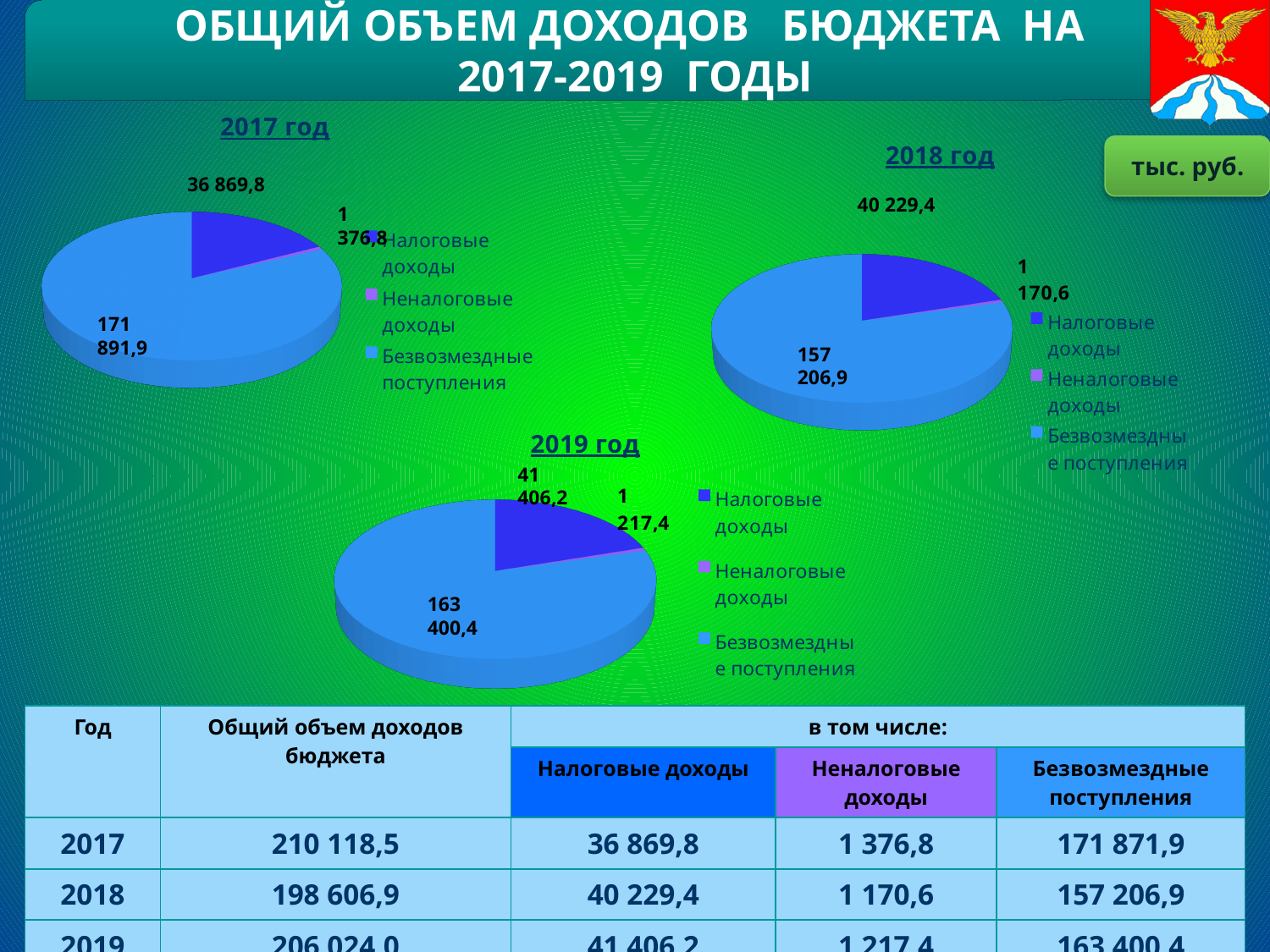
In the 2018 год pie chart, which category has the largest slice? Безвозмездные поступления In the 2018 год pie chart, what is the value for Безвозмездные поступления? 157 206,9 What kind of chart is used for the 2019 год data? Pie chart How many categories does the legend of the 2018 год chart list? 3 How many pie charts are shown on the slide? 3 In the 2018 год pie chart, which is larger: Налоговые доходы or Неналоговые доходы? Налоговые доходы In the 2019 год pie chart, what is the value for Безвозмездные поступления? 163 400,4 In the 2019 год pie chart, what is the value for Налоговые доходы? 41 406,2 In the 2019 год pie chart, what is the difference between Налоговые доходы and Неналоговые доходы? 40 188,8 In the 2018 год pie chart, what is the value for Неналоговые доходы? 1 170,6 In the 2017 год pie chart, which category has the smallest slice? Неналоговые доходы In the 2017 год pie chart, what is the value for Налоговые доходы? 36 869,8